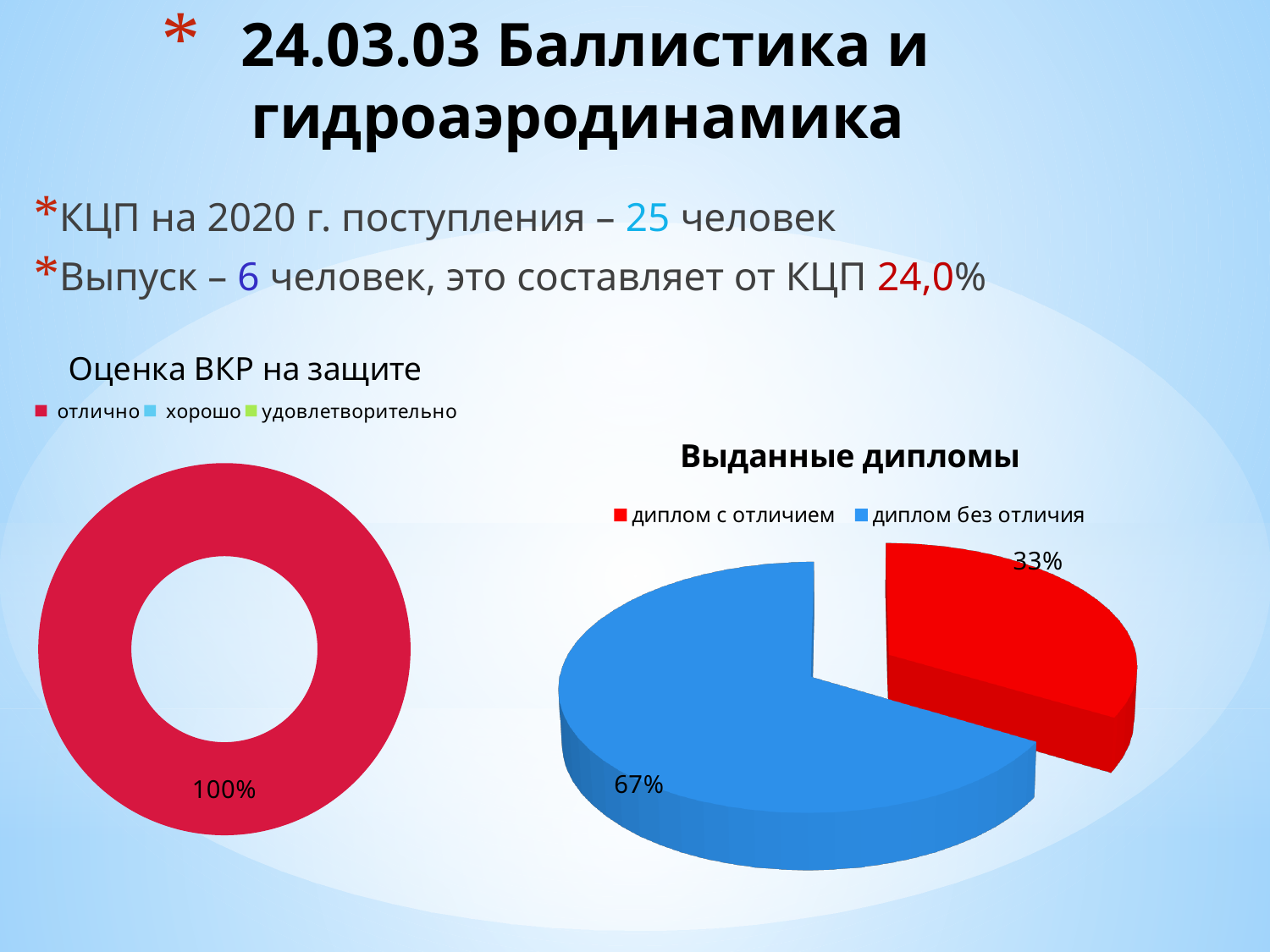
In the chart titled "Выданные дипломы", what is the difference in percentage points between "диплом без отличия" and "диплом с отличием"? 34 In the chart titled "Выданные дипломы", which is larger: "диплом с отличием" or "диплом без отличия"? диплом без отличия In the chart titled "Выданные дипломы", which category has the largest slice? диплом без отличия How many entries does the legend of the chart titled "Оценка ВКР на защите" list? 3 How many entries does the legend of the chart titled "Выданные дипломы" list? 2 In the chart titled "Оценка ВКР на защите", what percentage is shown on the single visible segment? 100% In the chart titled "Выданные дипломы", what share is labelled for "диплом с отличием"? 33% In the chart titled "Выданные дипломы", which category has the smallest slice? диплом с отличием What kind of chart is the chart titled "Выданные дипломы"? pie chart In the chart titled "Выданные дипломы", what share is labelled for "диплом без отличия"? 67% In the chart titled "Выданные дипломы", what colour is the slice for "диплом с отличием"? red In the chart titled "Оценка ВКР на защите", which legend category does the 100% segment belong to? отлично